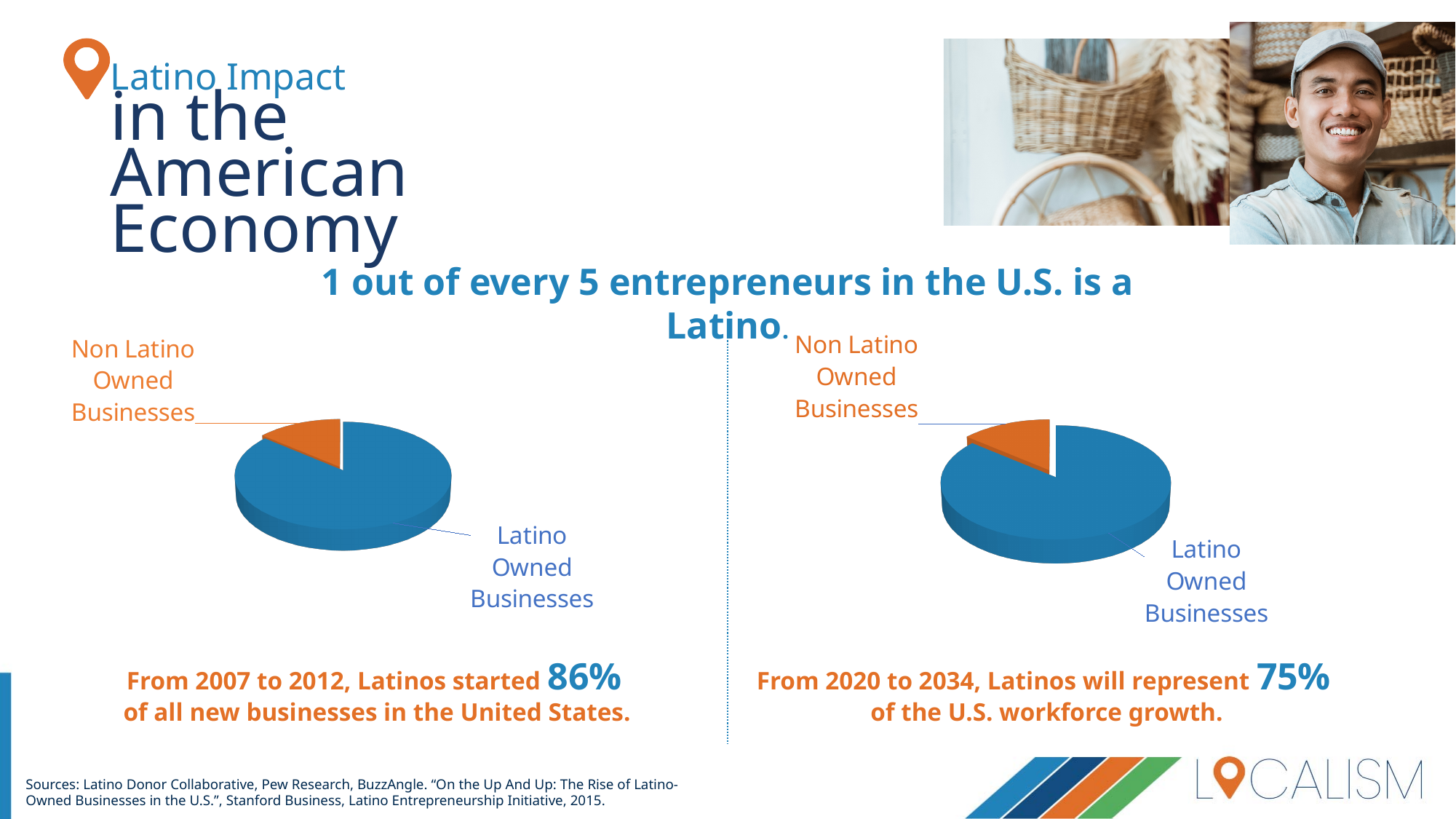
In the left pie chart, which slice is the smallest? Non Latino Owned Businesses In the right pie chart, which slice is the smallest? Non Latino Owned Businesses In the right pie chart, what colour is the Latino Owned Businesses slice? blue What kind of chart is the right chart on the slide? pie chart In the right pie chart, which slice is the largest? Latino Owned Businesses In the right pie chart, which is larger: the Non Latino Owned Businesses slice or the Latino Owned Businesses slice? Latino Owned Businesses What kind of chart is the left chart on the slide? pie chart How many slices does the left pie chart have? 2 In the left pie chart, which is larger: the Latino Owned Businesses slice or the Non Latino Owned Businesses slice? Latino Owned Businesses How many slices does the right pie chart have? 2 In the left pie chart, which slice is the largest? Latino Owned Businesses In the left pie chart, what colour is the Non Latino Owned Businesses slice? orange